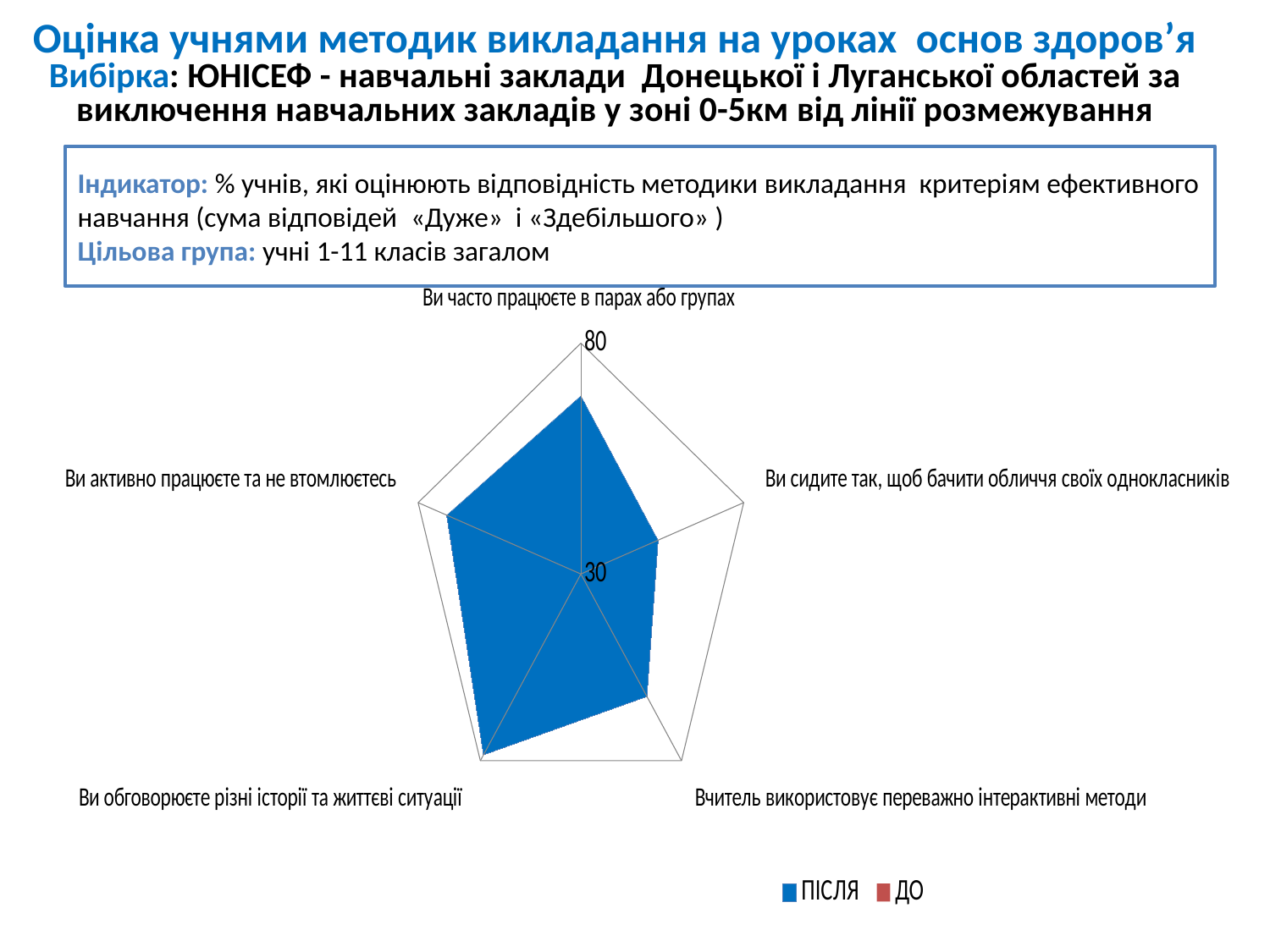
Is the ПІСЛЯ value for "Ви сидите так, щоб бачити обличчя своїх однокласників" greater or less than 30? greater Is the ПІСЛЯ value for "Вчитель використовує переважно інтерактивні методи" greater or less than 80? less How many series does the legend of the chart list? 2 For the ПІСЛЯ series, which is larger: the value for "Ви часто працюєте в парах або групах" or for "Ви сидите так, щоб бачити обличчя своїх однокласників"? Ви часто працюєте в парах або групах Which category has the highest value for the ПІСЛЯ series? Ви обговорюєте різні історії та життєві ситуації What are the two series names listed in the chart legend? ПІСЛЯ and ДО Is the ПІСЛЯ value for "Ви часто працюєте в парах або групах" greater or less than 80? less For the ПІСЛЯ series, which is larger: the value for "Ви обговорюєте різні історії та життєві ситуації" or for "Ви сидите так, щоб бачити обличчя своїх однокласників"? Ви обговорюєте різні історії та життєві ситуації What colour represents the ПІСЛЯ series in the chart? Blue Which category has the lowest value for the ПІСЛЯ series? Ви сидите так, щоб бачити обличчя своїх однокласників How many categories (axes) does the radar chart have? 5 What kind of chart is shown on the slide? Radar chart